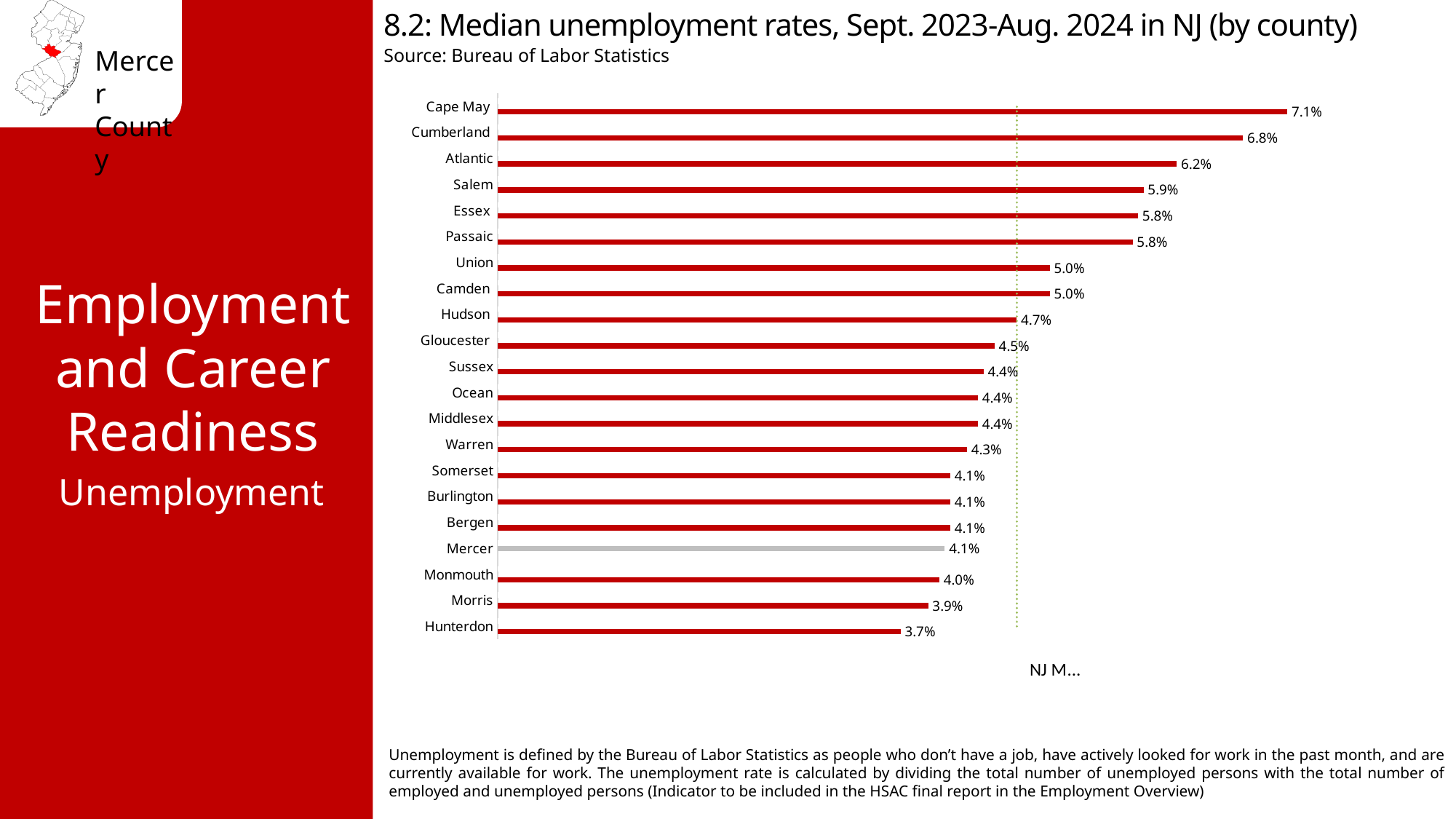
What type of chart is used to show the median unemployment rates? Bar chart Which county has a higher median unemployment rate, Salem or Union? Salem Which county has a higher median unemployment rate, Gloucester or Morris? Gloucester What is the difference between the median unemployment rates of Cape May and Hunterdon? 3.4% Which county has the highest median unemployment rate? Cape May What is the median unemployment rate for Hudson? 4.7% How many counties are shown in the chart? 21 What is the median unemployment rate for Mercer? 4.1% What is the median unemployment rate for Cape May? 7.1% Which county's bar is shown in grey instead of red? Mercer What is the difference between the median unemployment rates of Cumberland and Atlantic? 0.6% Which county has the lowest median unemployment rate? Hunterdon